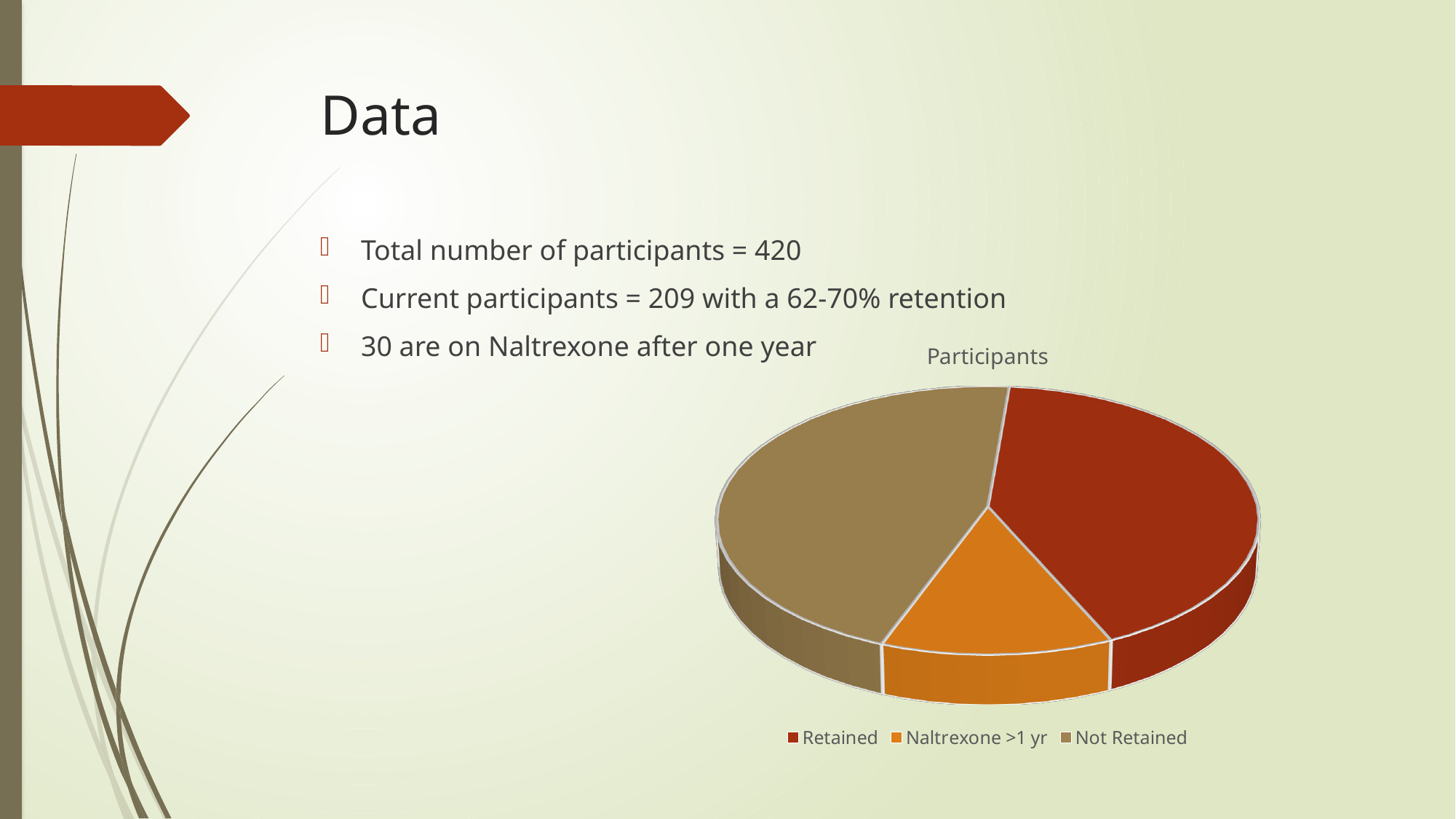
What is the title of the chart? Participants What kind of chart is shown on the slide? pie chart Which slice of the pie chart is the largest? Not Retained What colour is the Retained slice in the pie chart? red Which slice is larger, Not Retained or Naltrexone >1 yr? Not Retained How many entries does the chart legend list? 3 Which slice is larger, Retained or Naltrexone >1 yr? Retained How many slices does the pie chart have? 3 Which slice of the pie chart is the smallest? Naltrexone >1 yr